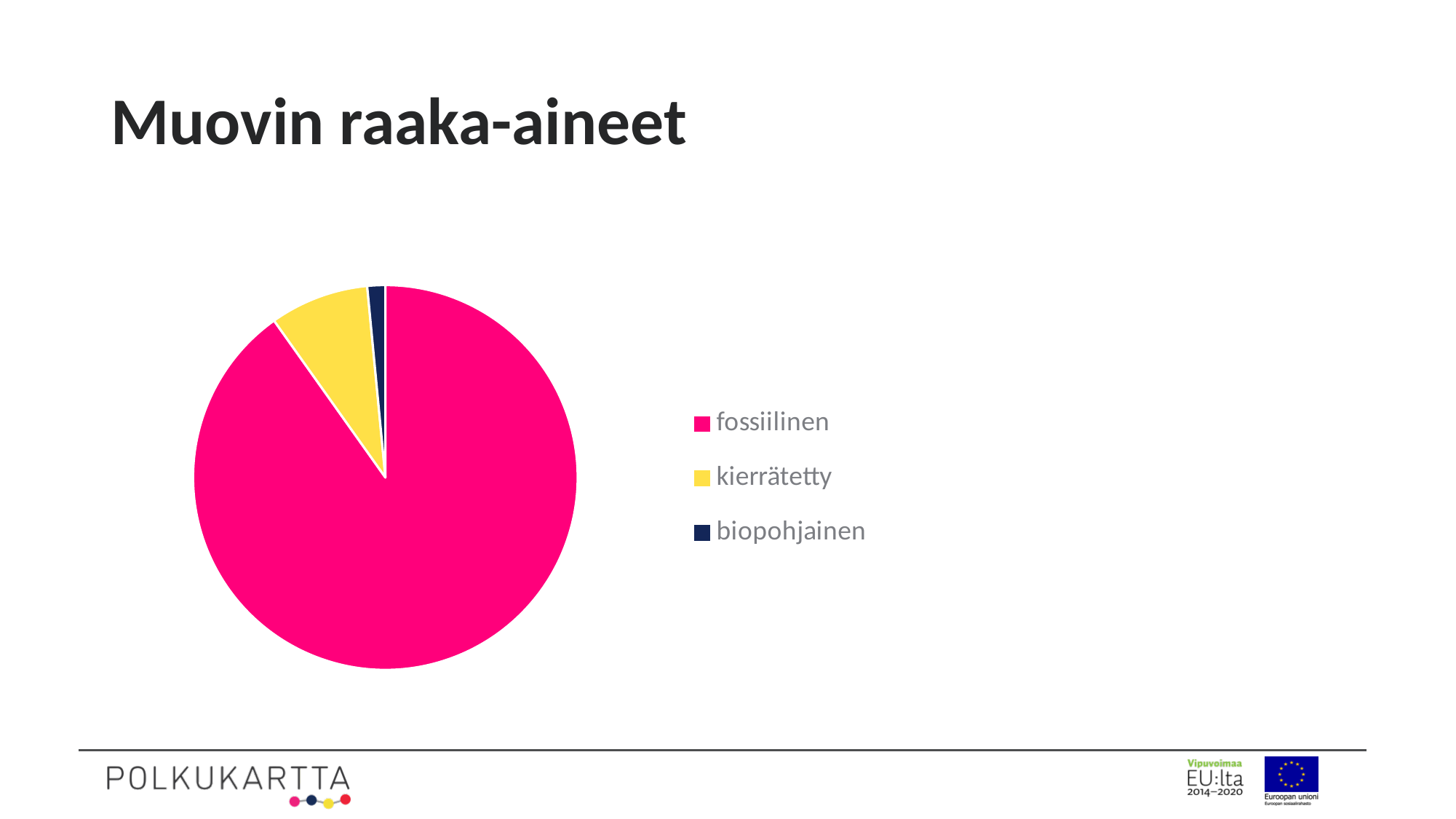
Which category has the smallest slice of the pie? biopohjainen Which category has the largest slice of the pie? fossiilinen How many slices does the pie chart have? 3 What colour is the fossiilinen slice in the pie chart? pink Which slice is larger, fossiilinen or kierrätetty? fossiilinen Which slice is larger, kierrätetty or biopohjainen? kierrätetty What kind of chart is shown on the slide? pie chart How many entries does the legend list? 3 What is the title of the slide containing the pie chart? Muovin raaka-aineet